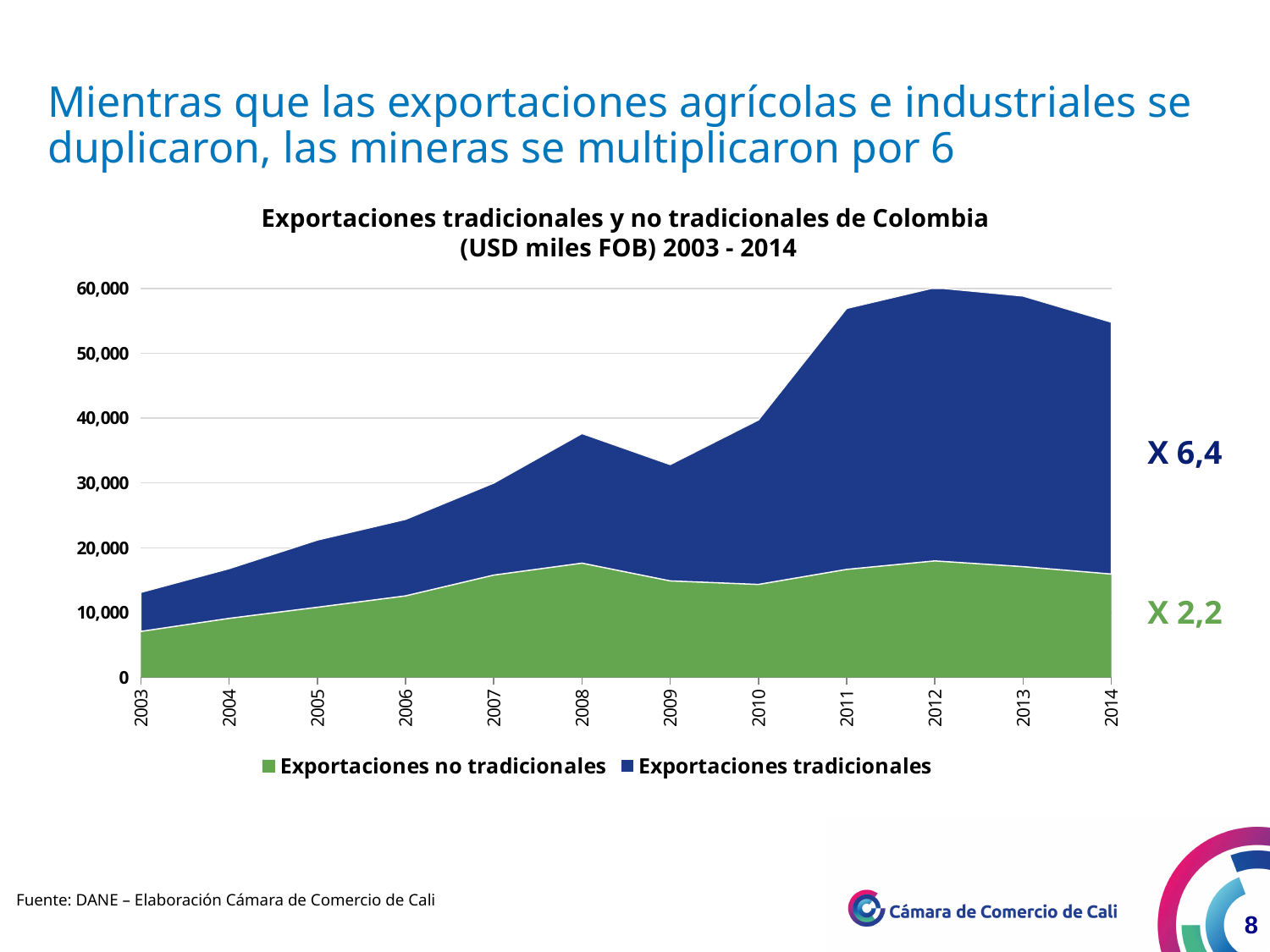
Which colour represents Exportaciones tradicionales in the chart? Blue In which year is the total of exports highest? 2012 What kind of chart is shown on the slide? Stacked area chart Is the value for Exportaciones no tradicionales in 2003 greater or less than 10,000? less How many years are plotted along the x axis of the chart? 12 Is the total of exports in 2009 greater or less than 40,000? less How many series does the chart's legend list? 2 Do total exports rise or fall from 2012 to 2014? fall In which year is the total of exports lowest? 2003 Is the total of exports in 2003 greater or less than 20,000? less Is the total of exports larger in 2010 or in 2011? 2011